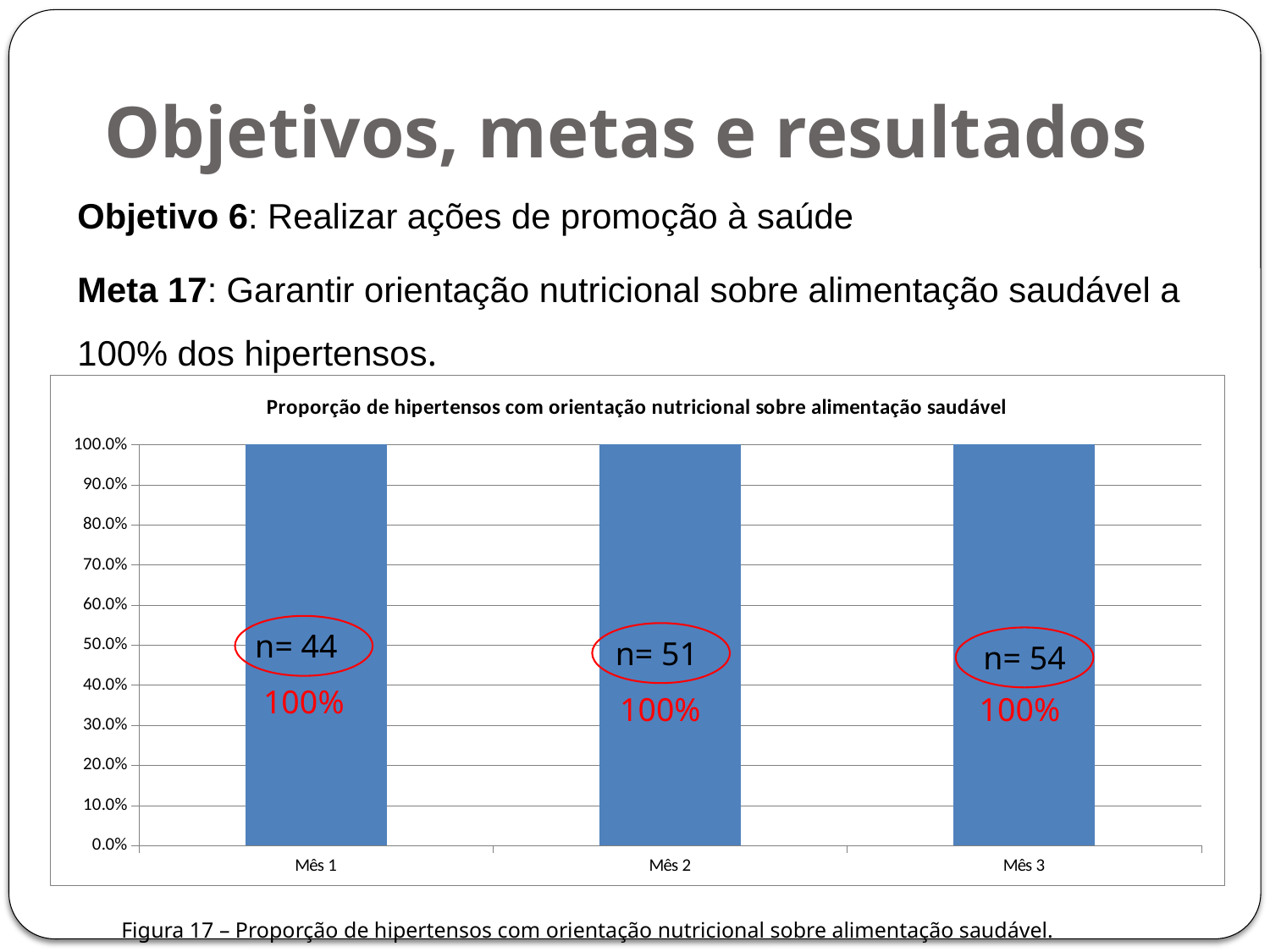
What is the n value annotated on the bar for Mês 3? n= 54 How many categories (months) are shown on the x axis of the chart? 3 What is the n value annotated on the bar for Mês 1? n= 44 What is the title of the chart? Proporção de hipertensos com orientação nutricional sobre alimentação saudável What is the n value annotated on the bar for Mês 2? n= 51 What is the value for Mês 3 in the chart? 100% Do the values rise, fall, or stay the same from Mês 1 to Mês 3? stay the same What is the value for Mês 2 in the chart? 100% What kind of chart is shown on the slide? bar chart Is the value for Mês 2 greater or less than 90.0%? greater What is the value for Mês 1 in the chart? 100% What is the difference between the values for Mês 3 and Mês 1? 0%